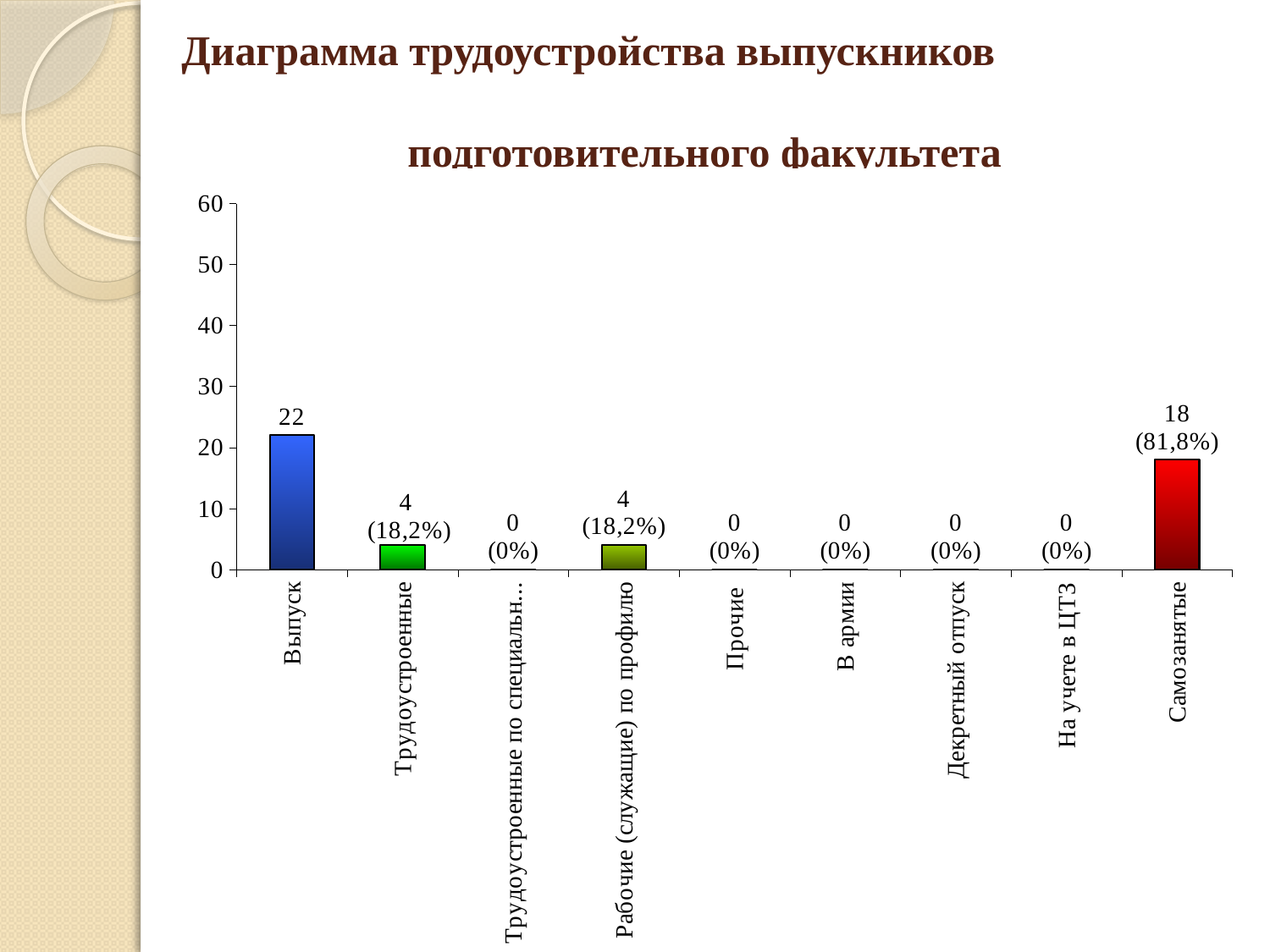
Which is larger, the value for Самозанятые or the value for Трудоустроенные? Самозанятые What is the difference between the values for Выпуск and Самозанятые? 4 What type of chart is shown on the slide? bar chart What is the value for Трудоустроенные? 4 What percentage is shown for Рабочие (служащие) по профилю? 18,2% What is the value for Самозанятые? 18 Which category has the highest value? Выпуск What is the value for Выпуск? 22 What is the maximum value shown on the y axis? 60 How many categories are shown on the x axis? 9 What is the value for В армии? 0 What percentage is shown for Самозанятые? 81,8%